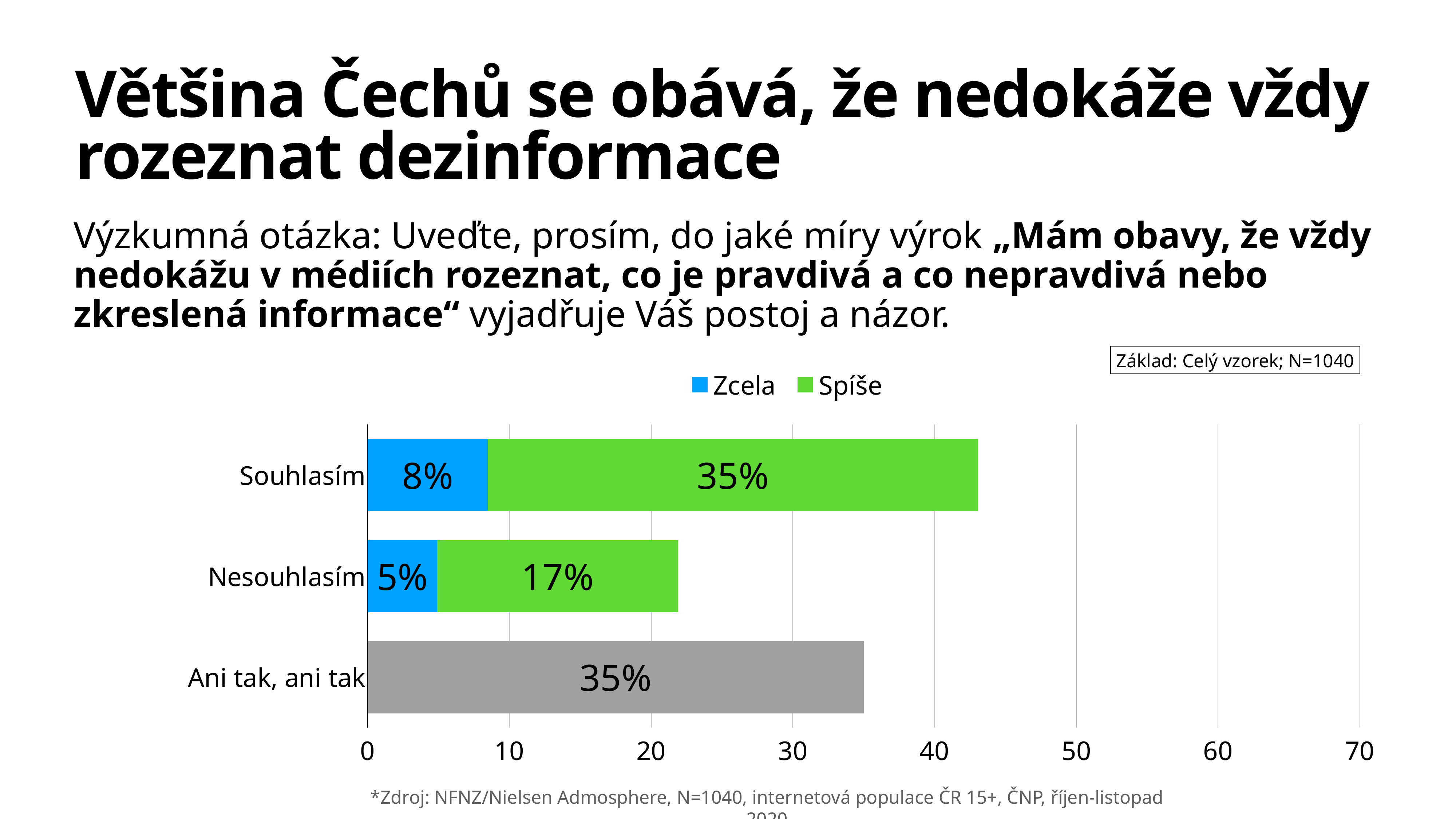
What is the total of the stacked bar for Souhlasím? 43% How many series does the legend list? 2 Which category has the shortest bar overall? Nesouhlasím What is the total of the stacked bar for Nesouhlasím? 22% What is the difference between the "Spíše" values for Souhlasím and Nesouhlasím? 18% What is the "Zcela" value for Nesouhlasím? 5% What kind of chart is shown on the slide? stacked bar chart What is the "Spíše" value for Nesouhlasím? 17% What is the "Zcela" value for Souhlasím? 8% Is the "Zcela" value for Souhlasím larger or smaller than the "Zcela" value for Nesouhlasím? larger Which category has the longest bar overall? Souhlasím What is the value shown for Ani tak, ani tak? 35%